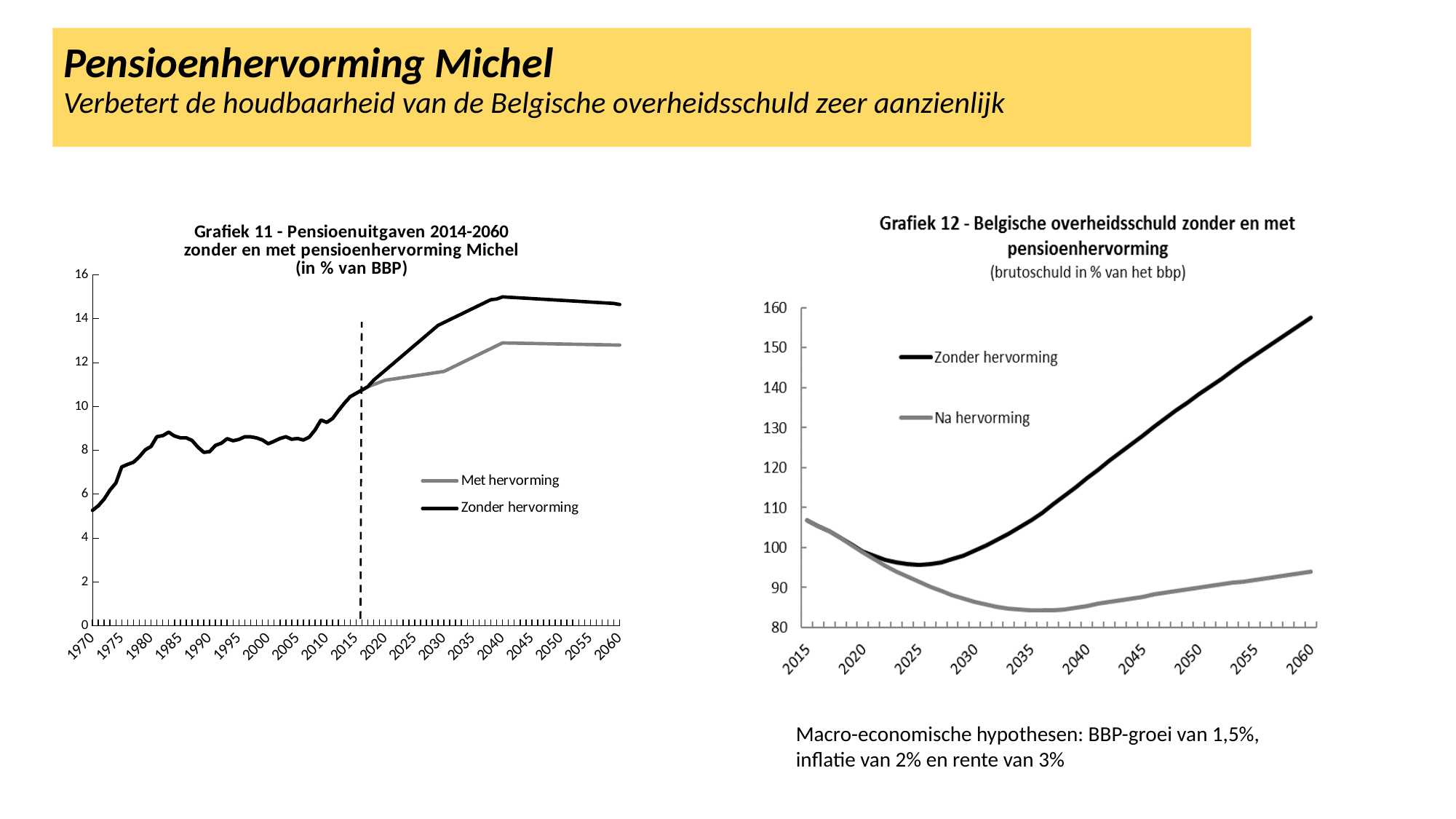
What are the two legend entries of Grafiek 12? Zonder hervorming and Na hervorming What kind of chart is Grafiek 11 on the left of the slide? line chart In Grafiek 11, is the value for Met hervorming in 2060 greater or less than 14? less In Grafiek 12, is the value for Zonder hervorming in 2060 greater or less than 150? greater What kind of chart is Grafiek 12 on the right of the slide? line chart How many series does the legend of Grafiek 11 list? 2 In Grafiek 11, which series is higher in 2060, Met hervorming or Zonder hervorming? Zonder hervorming How many series does the legend of Grafiek 12 list? 2 In Grafiek 11, is the value for Zonder hervorming in 2060 greater or less than 14? greater In Grafiek 12, does the Zonder hervorming line rise or fall between 2030 and 2060? rise In Grafiek 12, does the Na hervorming line rise or fall between 2015 and 2035? fall